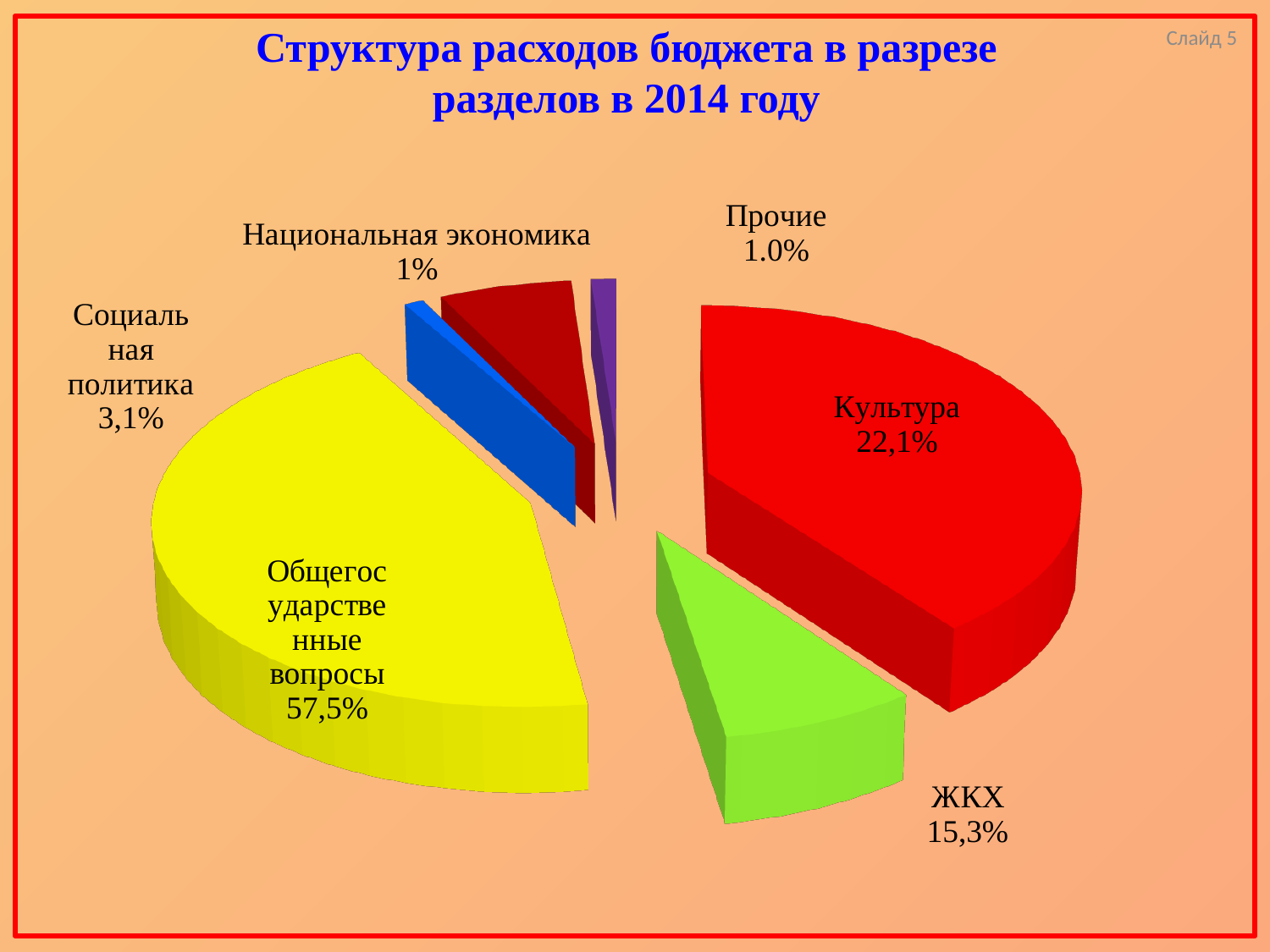
Which section has the largest share of budget expenditures? Общегосударственные вопросы What is the share for Прочие? 1.0% What is the share for Культура? 22,1% Which is larger, the share for Культура or the share for ЖКХ? Культура How many slices does the pie chart have? 6 What kind of chart is shown on the slide? Pie chart What is the share for Социальная политика? 3,1% What is the difference between the shares for Культура and ЖКХ? 6,8% What is the share for Национальная экономика? 1% What is the share for ЖКХ? 15,3% What is the title of the chart? Структура расходов бюджета в разрезе разделов в 2014 году What is the share for Общегосударственные вопросы? 57,5%